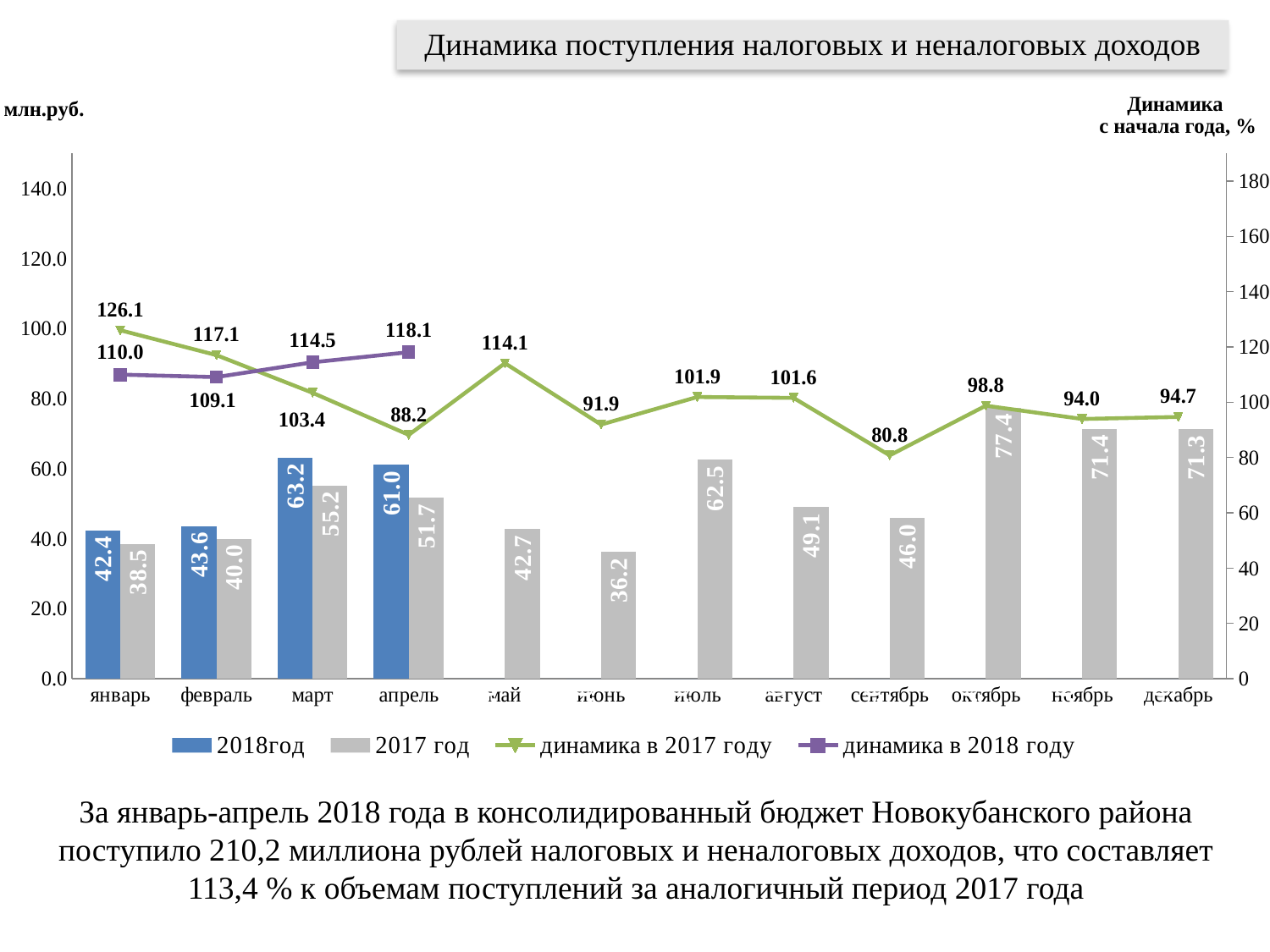
What is the value for март in the 2018год series? 63.2 Does the динамика в 2018 году line rise or fall from февраль to апрель? Rise Which is larger for январь: the 2018год value or the 2017 год value? 2018год What is the value for июнь in the 2017 год series? 36.2 How many months are shown on the x axis? 12 What is the value of динамика в 2018 году for апрель? 118.1 What kind of chart is this? Combined bar and line chart What is the difference between the 2018год and 2017 год values for март? 8.0 Which month has the lowest value in the 2017 год series? июнь How many series does the legend list? 4 What is the value of динамика в 2017 году for сентябрь? 80.8 Which month has the highest value in the 2017 год series? октябрь